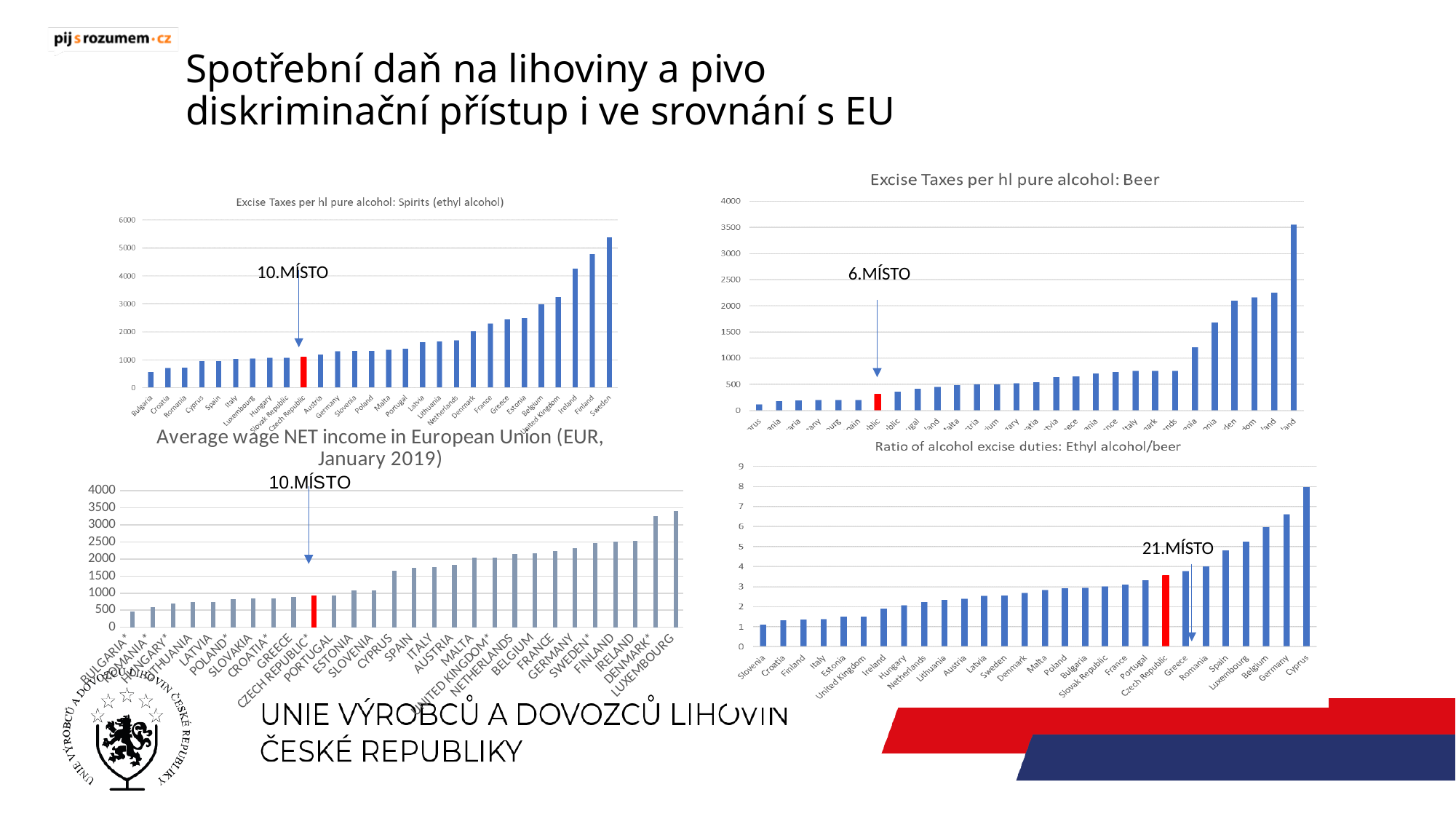
What type of chart is the 'Excise Taxes per hl pure alcohol: Spirits (ethyl alcohol)' chart? Bar chart In the 'Ratio of alcohol excise duties: Ethyl alcohol/beer' chart, which country has the lowest ratio? Slovenia In the 'Excise Taxes per hl pure alcohol: Spirits (ethyl alcohol)' chart, is the value for Sweden greater or less than 5000? greater In the 'Ratio of alcohol excise duties: Ethyl alcohol/beer' chart, how many countries are shown? 28 In the 'Average wage NET income in European Union (EUR, January 2019)' chart, which country has the highest value? Luxembourg In the 'Ratio of alcohol excise duties: Ethyl alcohol/beer' chart, which country has the highest ratio? Cyprus In the 'Excise Taxes per hl pure alcohol: Spirits (ethyl alcohol)' chart, which country has the lowest value? Bulgaria In the 'Excise Taxes per hl pure alcohol: Spirits (ethyl alcohol)' chart, which country has the highest value? Sweden In the 'Average wage NET income in European Union (EUR, January 2019)' chart, is the value for Czech Republic* greater or less than 1000? less In the 'Ratio of alcohol excise duties: Ethyl alcohol/beer' chart, is the value for Czech Republic greater or less than 3? greater In the 'Average wage NET income in European Union (EUR, January 2019)' chart, do the values rise or fall from left to right along the x axis? Rise In the 'Excise Taxes per hl pure alcohol: Spirits (ethyl alcohol)' chart, which country's bar is highlighted in red? Czech Republic